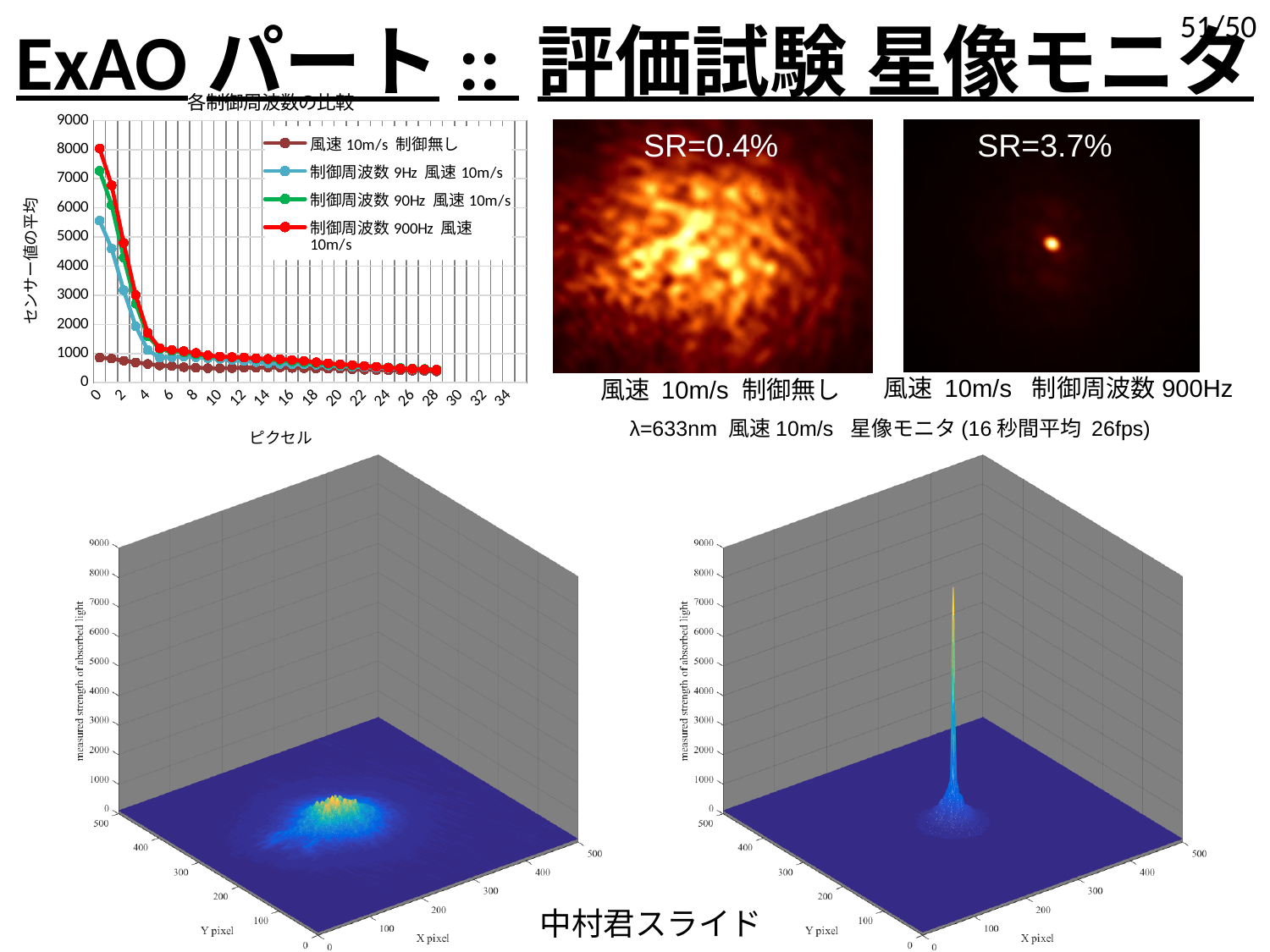
How many series does the legend of the top-left chart 各制御周波数の比較 list? 4 In the top-left chart 各制御周波数の比較, is the value of the 制御周波数 9Hz 風速 10m/s series at ピクセル 0 greater or less than 5000? greater What is the x-axis title of the top-left chart 各制御周波数の比較? ピクセル What is the highest tick value shown on the vertical axis of the bottom-left 3D plot? 9000 In the top-left chart 各制御周波数の比較, is the value of the 制御周波数 900Hz 風速 10m/s series at ピクセル 0 greater or less than 7000? greater What kind of chart is the top-left chart titled 各制御周波数の比較? line chart In the top-left chart 各制御周波数の比較, at ピクセル 0, which is larger: the 制御周波数 9Hz 風速 10m/s series or the 制御周波数 90Hz 風速 10m/s series? 制御周波数 90Hz 風速 10m/s What is the y-axis title of the top-left chart 各制御周波数の比較? センサー値の平均 In the top-left chart 各制御周波数の比較, which series has the lowest value at ピクセル 0? 風速 10m/s 制御無し In the top-left chart 各制御周波数の比較, is the value of the 風速 10m/s 制御無し series at ピクセル 0 greater or less than 1000? less In the top-left chart 各制御周波数の比較, do the values rise or fall as ピクセル increases along the x axis? fall In the top-left chart 各制御周波数の比較, which series has the highest value at ピクセル 0? 制御周波数 900Hz 風速 10m/s